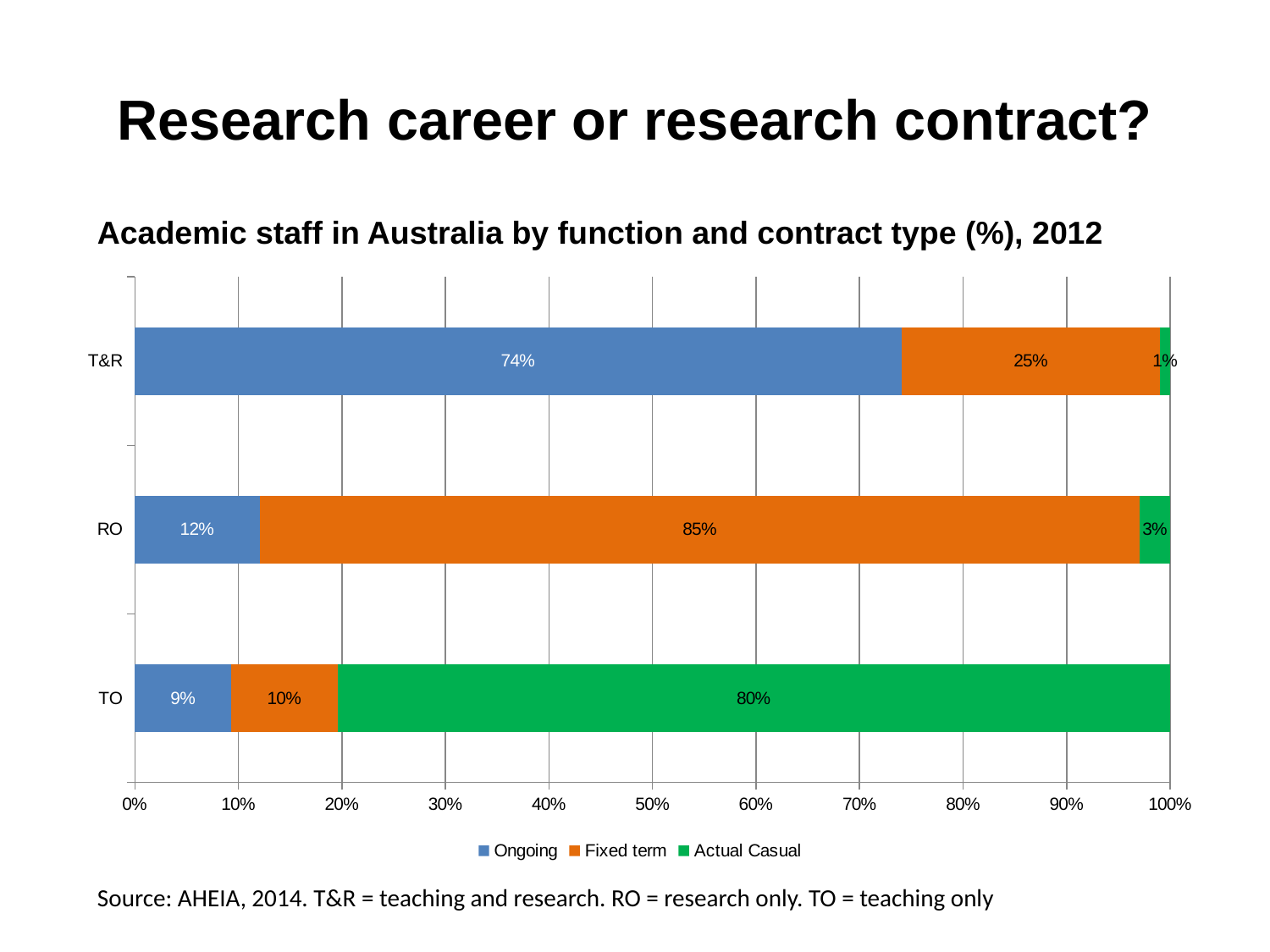
Which colour represents the Fixed term series? Orange What percentage of T&R academic staff are on Ongoing contracts? 74% How many series does the legend list? 3 Which is larger: the Ongoing share for TO or the Fixed term share for TO? Fixed term share for TO What is the difference between the Fixed term share for RO and the Fixed term share for T&R? 60% What kind of chart is shown on the slide? Stacked bar chart How many functions (categories) are shown on the chart? 3 What percentage of RO academic staff are on Fixed term contracts? 85% Which function has the highest share of Ongoing staff? T&R Which function has the lowest share of Actual Casual staff? T&R What percentage of TO academic staff are Actual Casual? 80% What percentage of RO academic staff are on Ongoing contracts? 12%